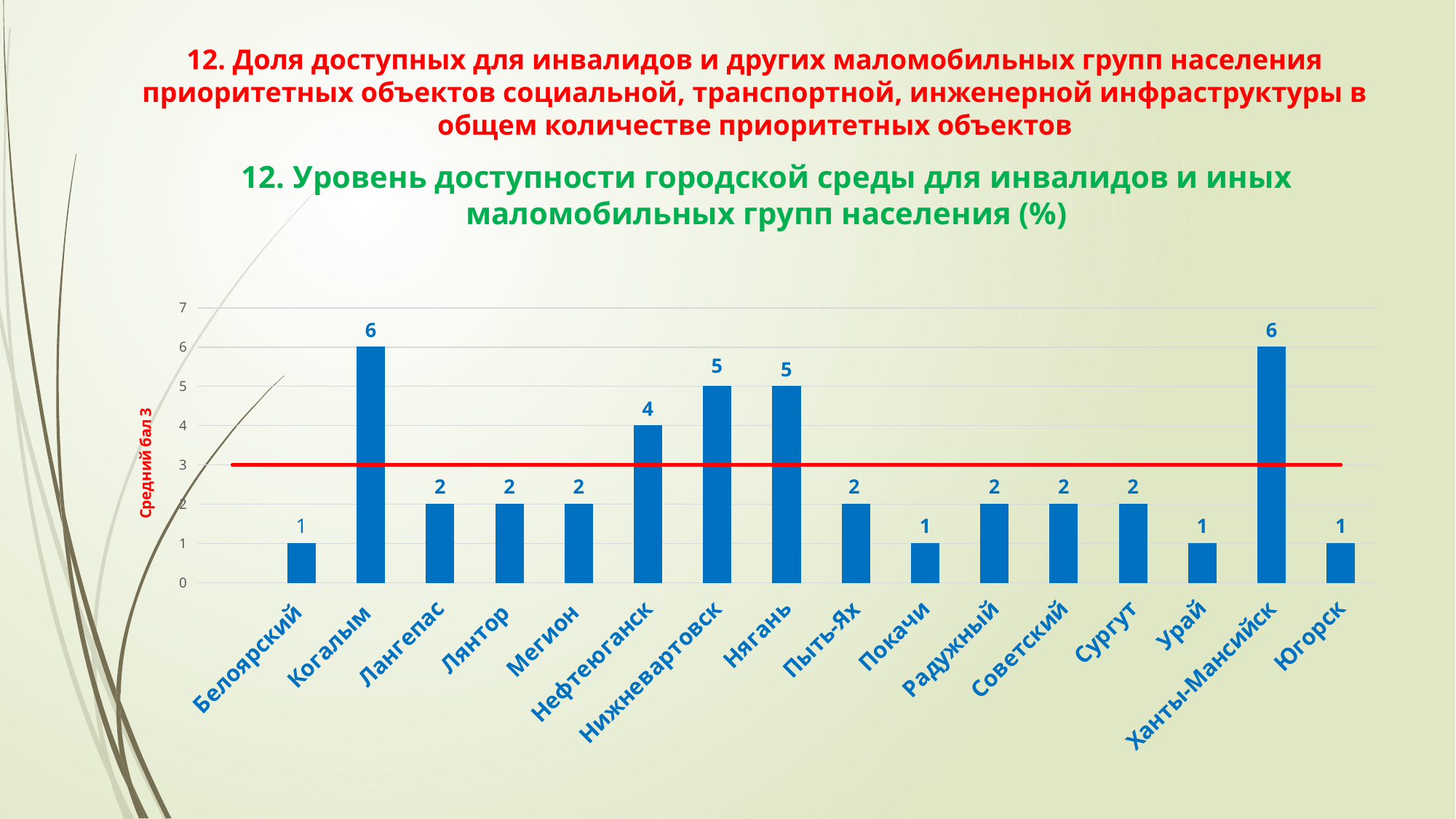
What is the value for Сургут? 2 What is the value for Нижневартовск? 5 What is the highest value shown on the chart? 6 What is the value for Урай? 1 What is the value for Нефтеюганск? 4 Which is larger, the value for Нягань or the value for Пыть-Ях? Нягань Is the value for Нефтеюганск greater or less than 3? greater What is the difference between the values for Когалым and Лангепас? 4 What value does the red horizontal line mark, according to its label? 3 Which two cities share the highest value on the chart? Когалым and Ханты-Мансийск How many cities are shown on the x axis? 16 What kind of chart is shown on the slide? combination bar and line chart